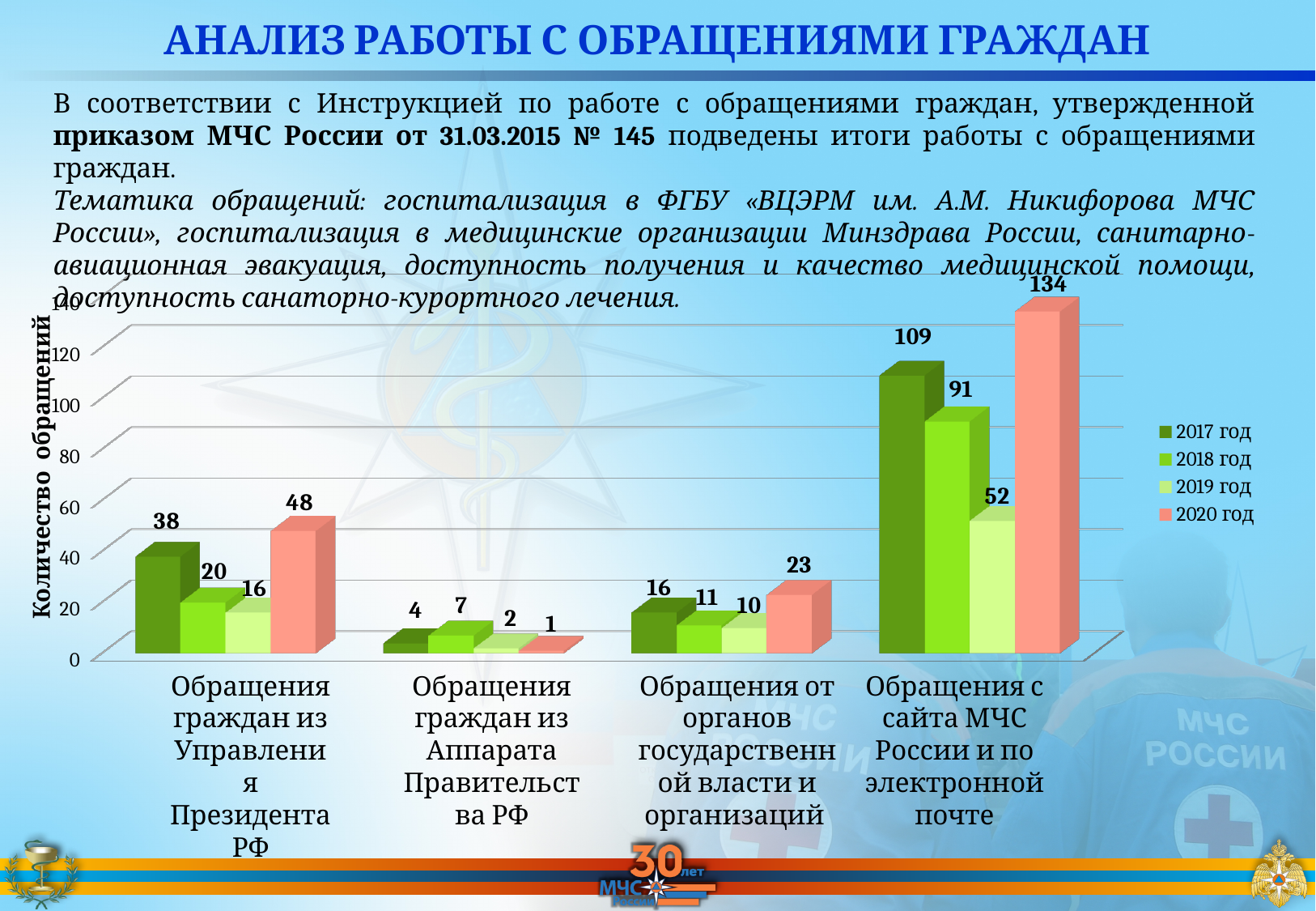
Which is larger for 'Обращения граждан из Управления Президента РФ': the 2017 год value or the 2020 год value? 2020 год What is the difference between the 2020 год and 2019 год values for 'Обращения с сайта МЧС России и по электронной почте'? 82 What kind of chart is shown on the slide? Bar chart Which category has the lowest value for 2020 год? Обращения граждан из Аппарата Правительства РФ How many series does the legend list? 4 What is the value for 2017 год for 'Обращения граждан из Управления Президента РФ'? 38 Which category has the highest value for 2017 год? Обращения с сайта МЧС России и по электронной почте What is the value for 2020 год for 'Обращения с сайта МЧС России и по электронной почте'? 134 How many categories are shown on the x axis? 4 What is the label of the vertical axis? Количество обращений What is the value for 2019 год for 'Обращения граждан из Аппарата Правительства РФ'? 2 What is the value for 2018 год for 'Обращения от органов государственной власти и организаций'? 11